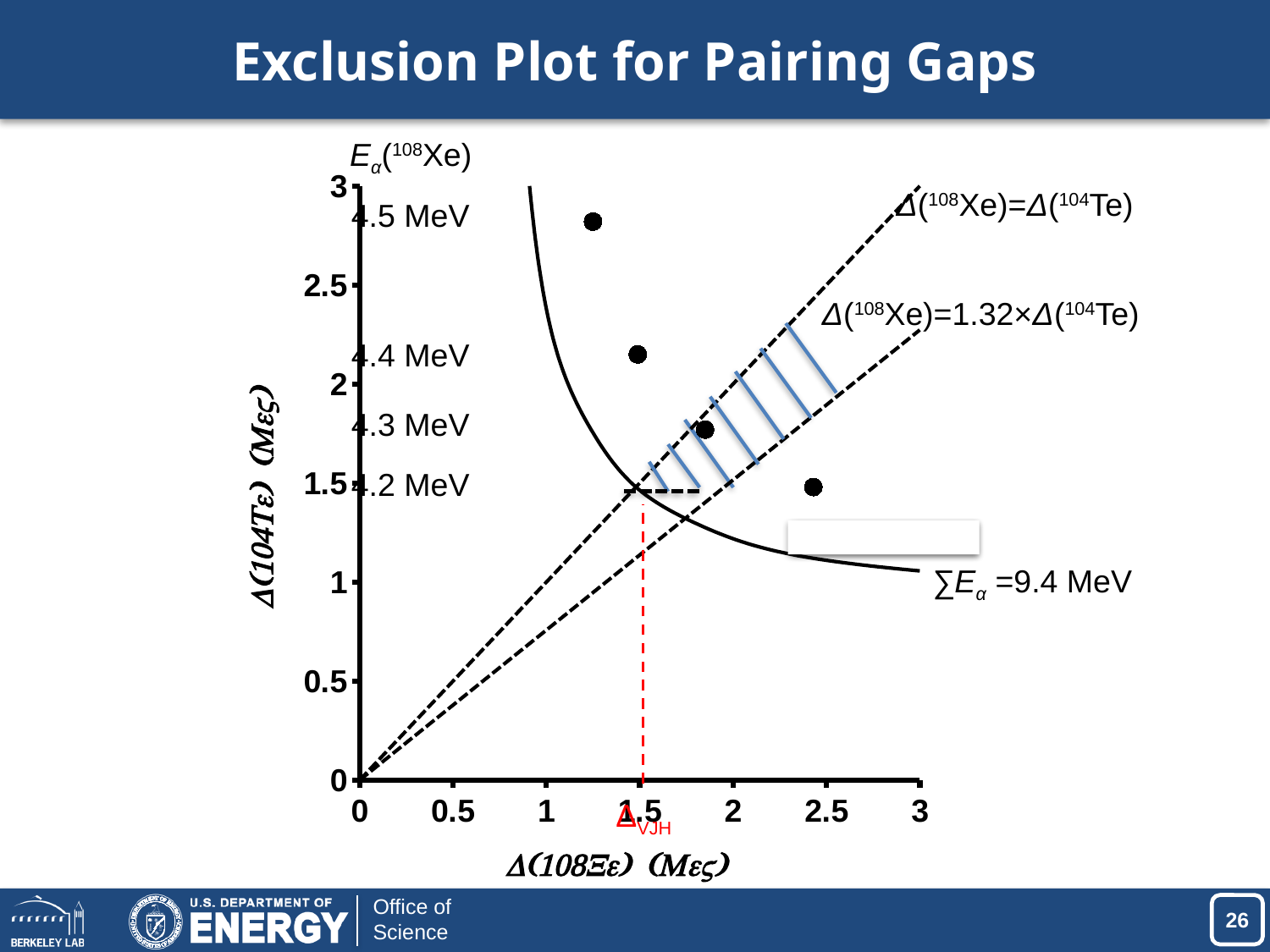
Is the y value of the highest black data point greater or less than 2.5? greater How many black dashed straight lines radiate from the origin? 2 What is the maximum value shown on the x axis? 3 What kind of chart is shown on the slide? scatter plot What is the title of the slide's chart? Exclusion Plot for Pairing Gaps How many tick labels are shown along the x axis? 7 Is the x value of the rightmost black data point greater or less than 2? greater What multiplying factor appears in the label of the lower dashed line, Δ(108Xe)=?×Δ(104Te)? 1.32 Is the x value of the leftmost black data point greater or less than 1.5? less What is the maximum value shown on the y axis? 3 At what x-axis value is the red dashed vertical line drawn? 1.5 How many black data points are plotted on the chart? 4